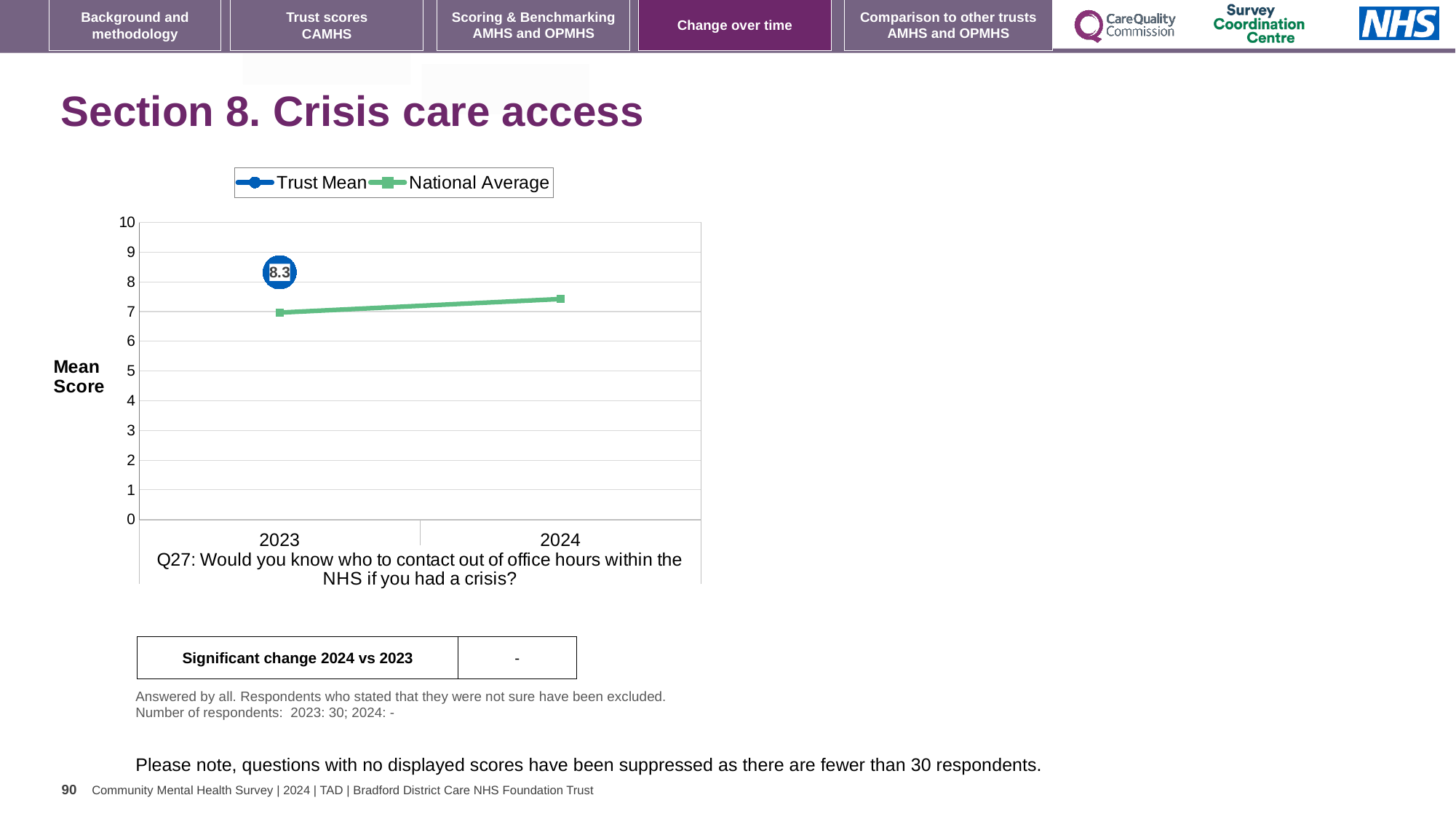
Is a Trust Mean value plotted for 2024? No What are the two series named in the legend? Trust Mean and National Average Is the National Average for 2023 greater or less than 8? less How many years are shown on the x axis? 2 Is the National Average for 2024 greater or less than 7? greater What kind of chart is shown on the slide? Line chart Is the National Average for 2023 greater or less than 6? greater What is the label on the y axis of the chart? Mean Score How many series does the legend list? 2 What is the Trust Mean score for 2023? 8.3 Does the National Average rise or fall from 2023 to 2024? Rises In 2023, which is higher: the Trust Mean or the National Average? Trust Mean